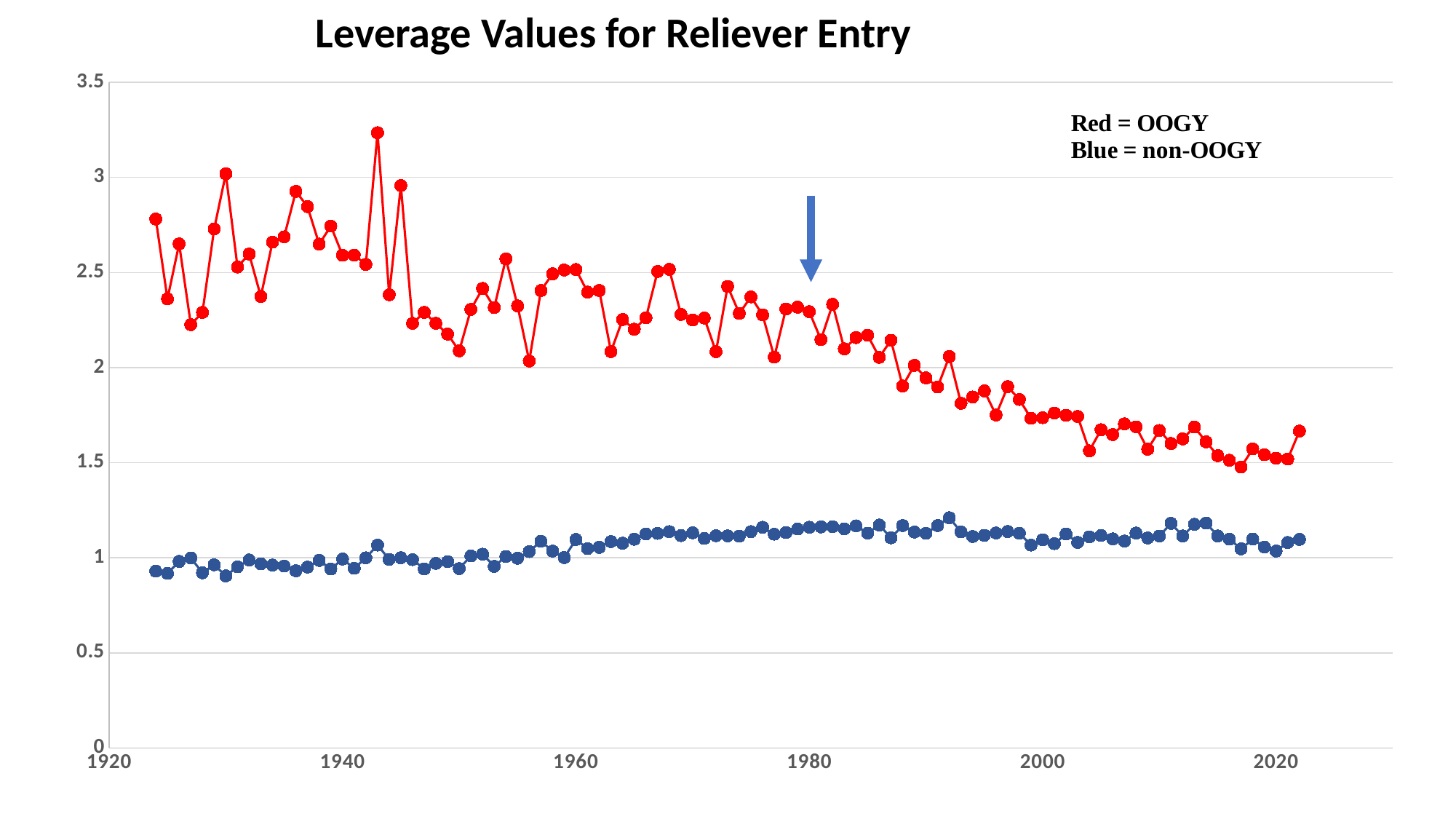
Which series has higher leverage values throughout the chart, OOGY or non-OOGY? OOGY Is the red OOGY value around 2000 greater or less than 2? less Is the red OOGY value around 1980 greater or less than 2? greater Does the red OOGY series generally rise or fall from 1920 to 2020? fall Does the blue non-OOGY series generally rise or fall from 1920 to 2020? rise What kind of chart is shown on the slide? line chart How many data series are plotted on the chart? 2 What is the title of the chart? Leverage Values for Reliever Entry Is the highest value of the red OOGY series greater or less than 3? greater According to the legend text, which series is shown in red? OOGY